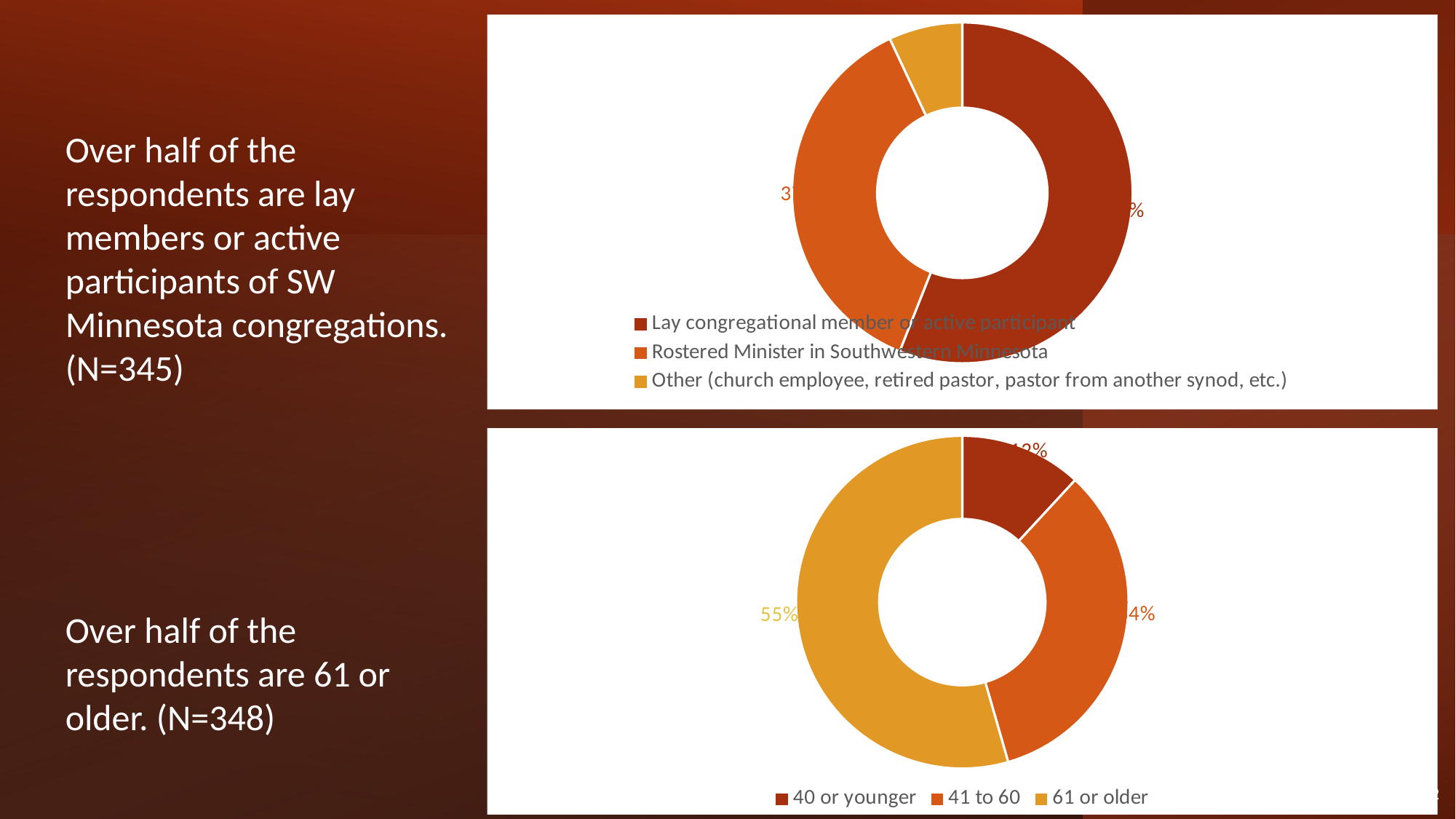
What kind of chart is the top chart on the slide? doughnut chart In the top chart, which category has the smallest share? Other (church employee, retired pastor, pastor from another synod, etc.) In the bottom chart, which age group has the smallest share? 40 or younger In the bottom chart, what share of respondents are 61 or older? 55% In the bottom chart, which colour represents the 61 or older category? yellow-orange What kind of chart is the bottom chart on the slide? doughnut chart In the bottom chart, how many categories does the legend list? 3 In the bottom chart, which is larger: the share for 41 to 60 or the share for 40 or younger? 41 to 60 In the top chart, which category has the largest share? Lay congregational member or active participant In the top chart, how many categories does the legend list? 3 In the top chart, which is larger: the share for Rostered Minister in Southwestern Minnesota or the share for Other? Rostered Minister in Southwestern Minnesota In the bottom chart, which age group has the largest share? 61 or older